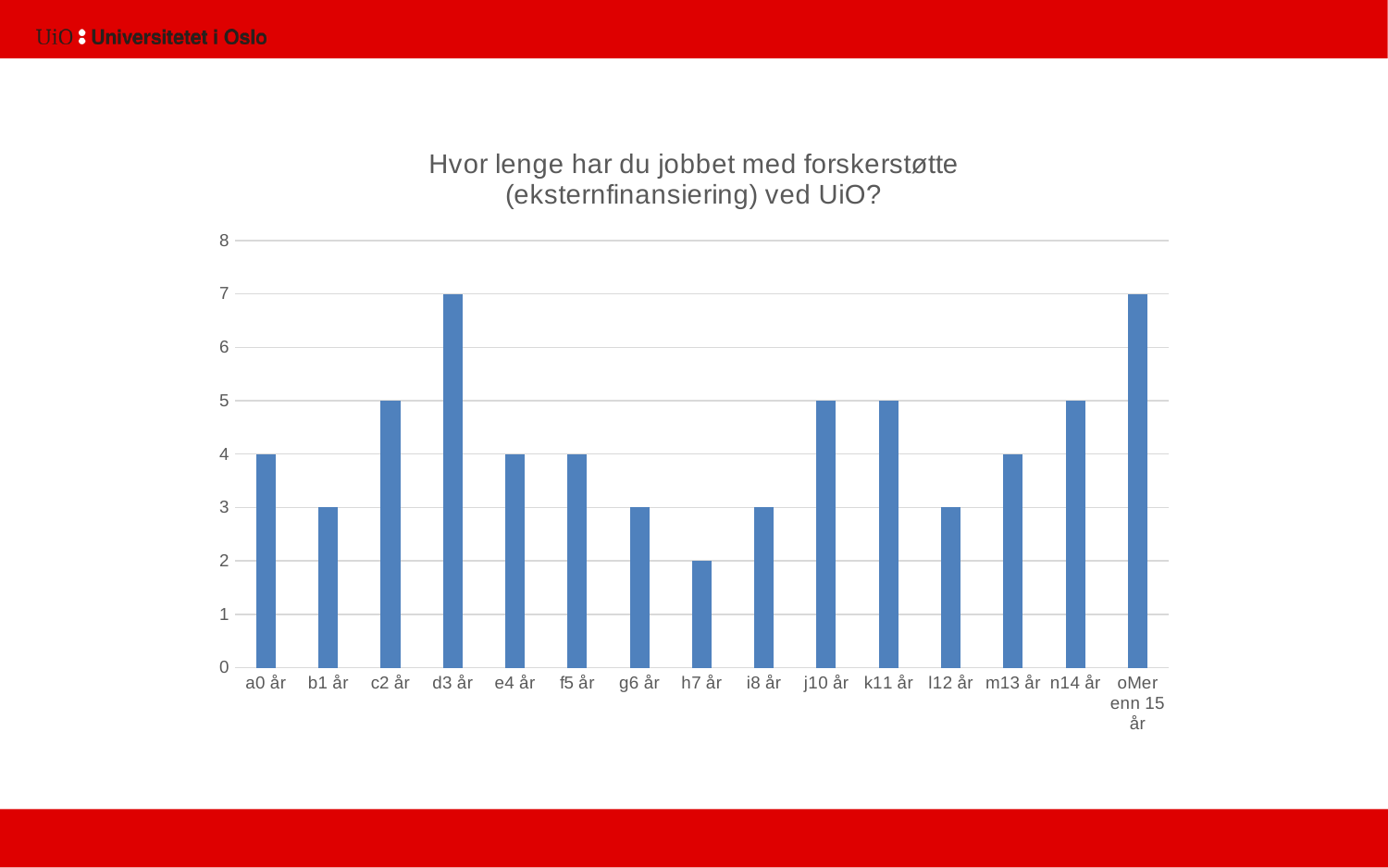
Is the value for oMer enn 15 år greater or less than 6? greater What is the value for d3 år? 7 What is the value for a0 år? 4 What is the value for h7 år? 2 What kind of chart is shown on the slide? bar chart What is the title of the chart? Hvor lenge har du jobbet med forskerstøtte (eksternfinansiering) ved UiO? Which category has the lowest value in the chart? h7 år Which is larger, the value for c2 år or the value for b1 år? c2 år How many categories are shown on the x axis of the chart? 15 What is the difference between the value for d3 år and the value for h7 år? 5 What is the value for j10 år? 5 Is the value for g6 år greater or less than 4? less